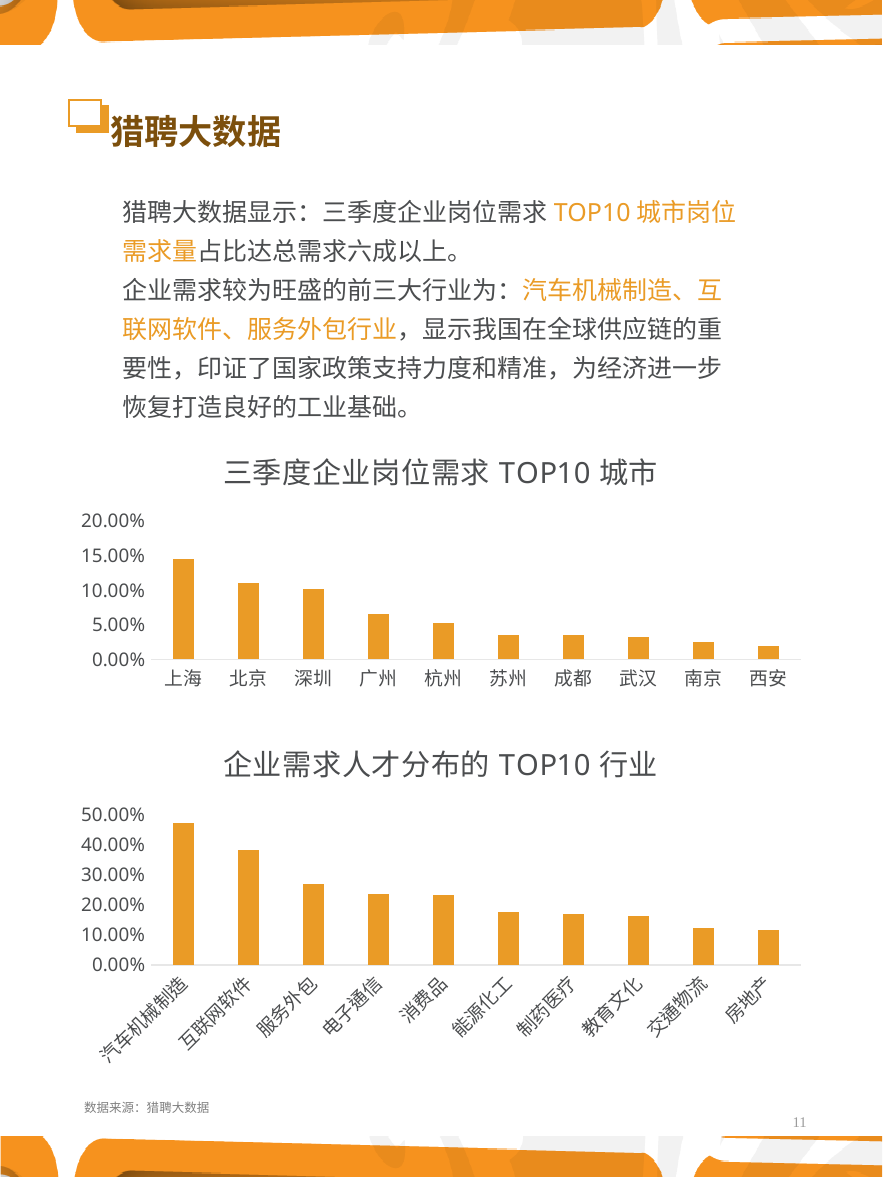
In the chart titled 三季度企业岗位需求 TOP10 城市, how many cities are shown? 10 In the chart titled 企业需求人才分布的 TOP10 行业, which industry has the highest value? 汽车机械制造 In the chart titled 三季度企业岗位需求 TOP10 城市, which is larger, the value for 上海 or the value for 广州? 上海 In the chart titled 企业需求人才分布的 TOP10 行业, is the value for 互联网软件 greater or less than 30.00%? greater In the chart titled 企业需求人才分布的 TOP10 行业, how many industries are shown? 10 In the chart titled 三季度企业岗位需求 TOP10 城市, is the value for 上海 greater or less than 10.00%? greater In the chart titled 三季度企业岗位需求 TOP10 城市, is the value for 广州 greater or less than 10.00%? less What kind of chart is the chart titled 三季度企业岗位需求 TOP10 城市? bar chart In the chart titled 三季度企业岗位需求 TOP10 城市, which city has the highest value? 上海 In the chart titled 三季度企业岗位需求 TOP10 城市, do the values rise or fall from left to right? fall In the chart titled 企业需求人才分布的 TOP10 行业, which is larger, the value for 互联网软件 or the value for 能源化工? 互联网软件 In the chart titled 三季度企业岗位需求 TOP10 城市, which city has the lowest value? 西安